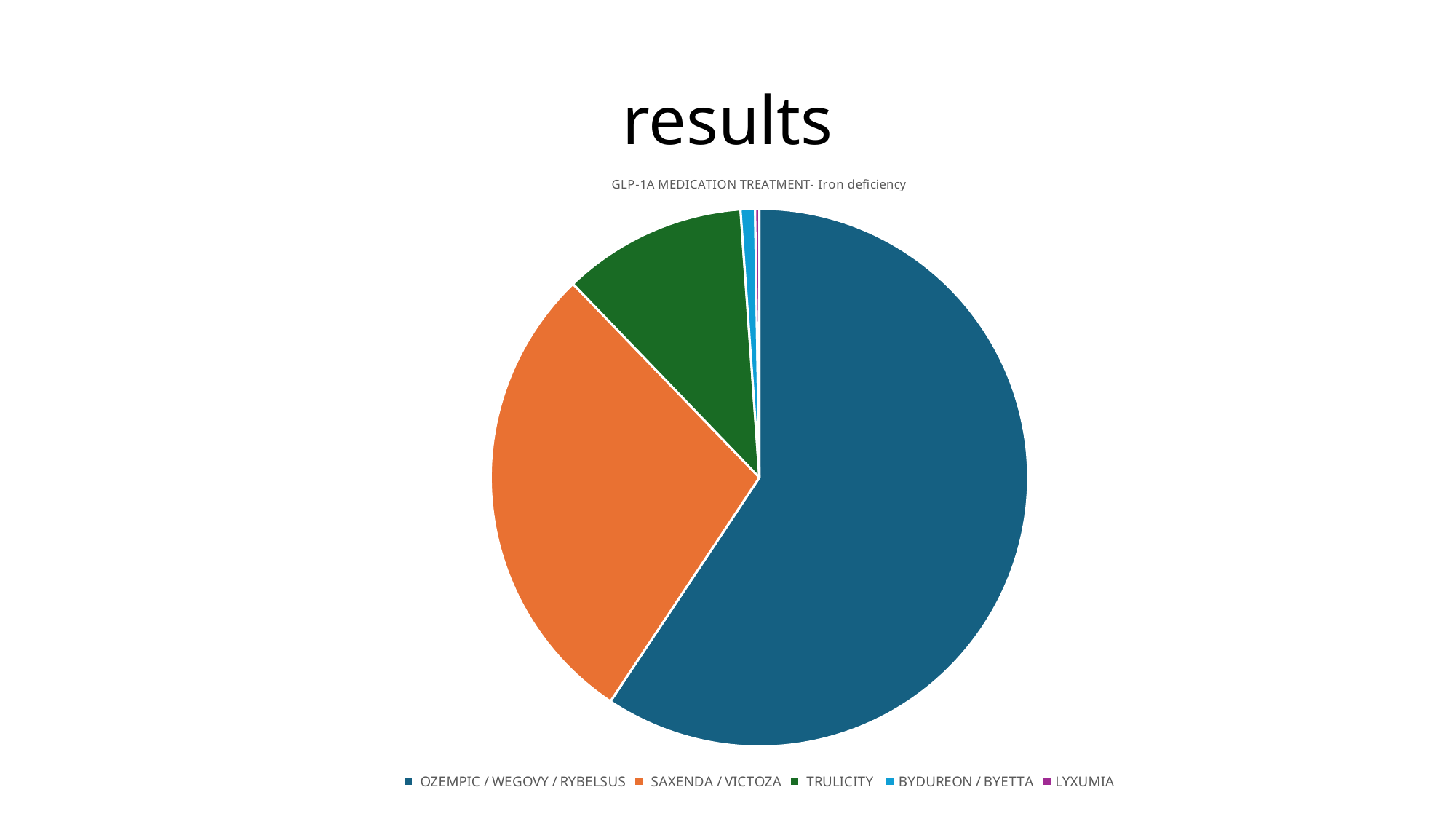
What kind of chart is shown on the slide? pie chart How many entries does the legend list? 5 Which slice is larger, OZEMPIC / WEGOVY / RYBELSUS or SAXENDA / VICTOZA? OZEMPIC / WEGOVY / RYBELSUS How many slices does the pie chart have? 5 Which category has the second-largest slice of the pie? SAXENDA / VICTOZA Which slice is larger, TRULICITY or BYDUREON / BYETTA? TRULICITY What is the title of the chart? GLP-1A MEDICATION TREATMENT- Iron deficiency Which category has the largest slice of the pie? OZEMPIC / WEGOVY / RYBELSUS Which category has the smallest slice of the pie? LYXUMIA Which category is shown in orange in the pie chart? SAXENDA / VICTOZA